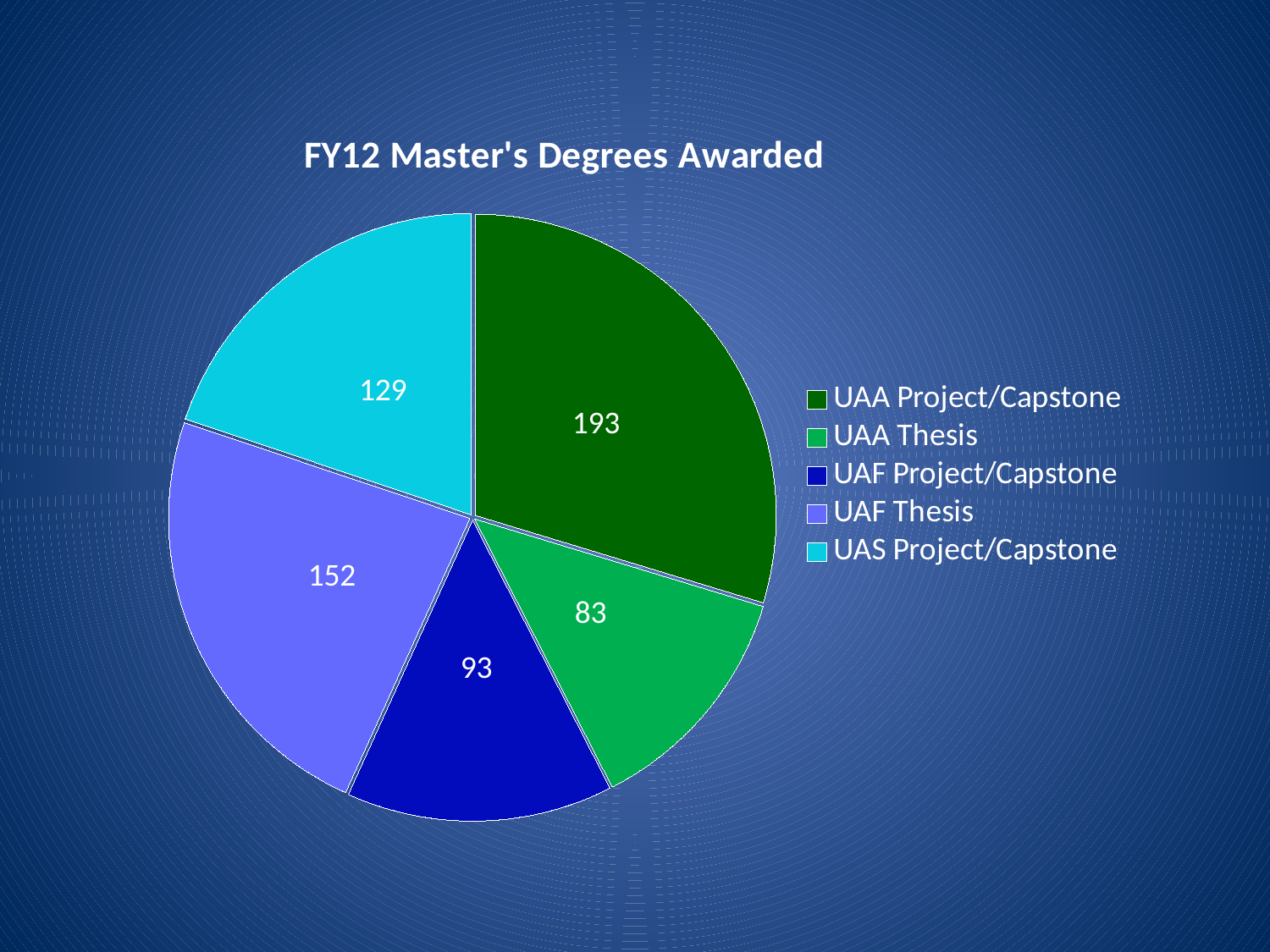
How many master's degrees were awarded for UAA Project/Capstone? 193 What is the title of the chart? FY12 Master's Degrees Awarded What is the difference between the UAA Project/Capstone and UAF Thesis values? 41 Which is larger, UAF Project/Capstone or UAA Thesis? UAF Project/Capstone What type of chart is shown on the slide? Pie chart How many master's degrees were awarded for UAF Thesis? 152 Which category has the smallest slice of the pie? UAA Thesis What is the total number of master's degrees shown across all slices? 650 Which category has the largest slice of the pie? UAA Project/Capstone How many master's degrees were awarded for UAA Thesis? 83 How many master's degrees were awarded for UAS Project/Capstone? 129 How many categories does the pie chart have? 5